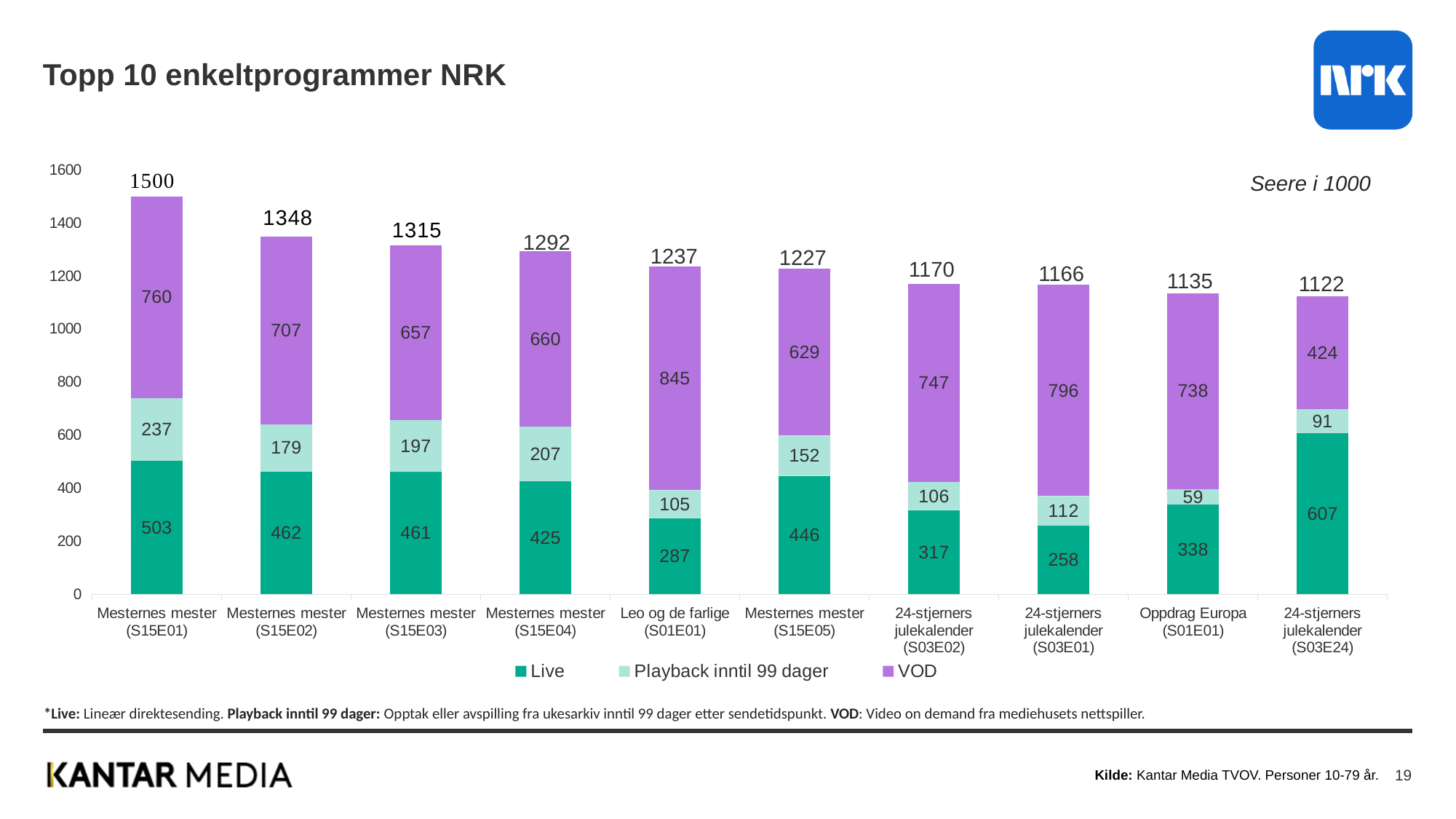
How many series does the legend list? 3 Which program has the lowest Playback inntil 99 dager value? Oppdrag Europa (S01E01) What unit is indicated for the values in the chart? Seere i 1000 Which is larger, the Live value for 24-stjerners julekalender (S03E24) or the Live value for Mesternes mester (S15E01)? 24-stjerners julekalender (S03E24) What is the Live value for Leo og de farlige (S01E01)? 287 What is the VOD value for 24-stjerners julekalender (S03E01)? 796 What is the total of the stacked bar for 24-stjerners julekalender (S03E24)? 1122 How many programs are shown on the x axis? 10 What kind of chart is shown on the slide? Stacked bar chart What is the Playback inntil 99 dager value for Oppdrag Europa (S01E01)? 59 What is the difference between the VOD values for Leo og de farlige (S01E01) and Mesternes mester (S15E05)? 216 Which program has the highest total viewers? Mesternes mester (S15E01)